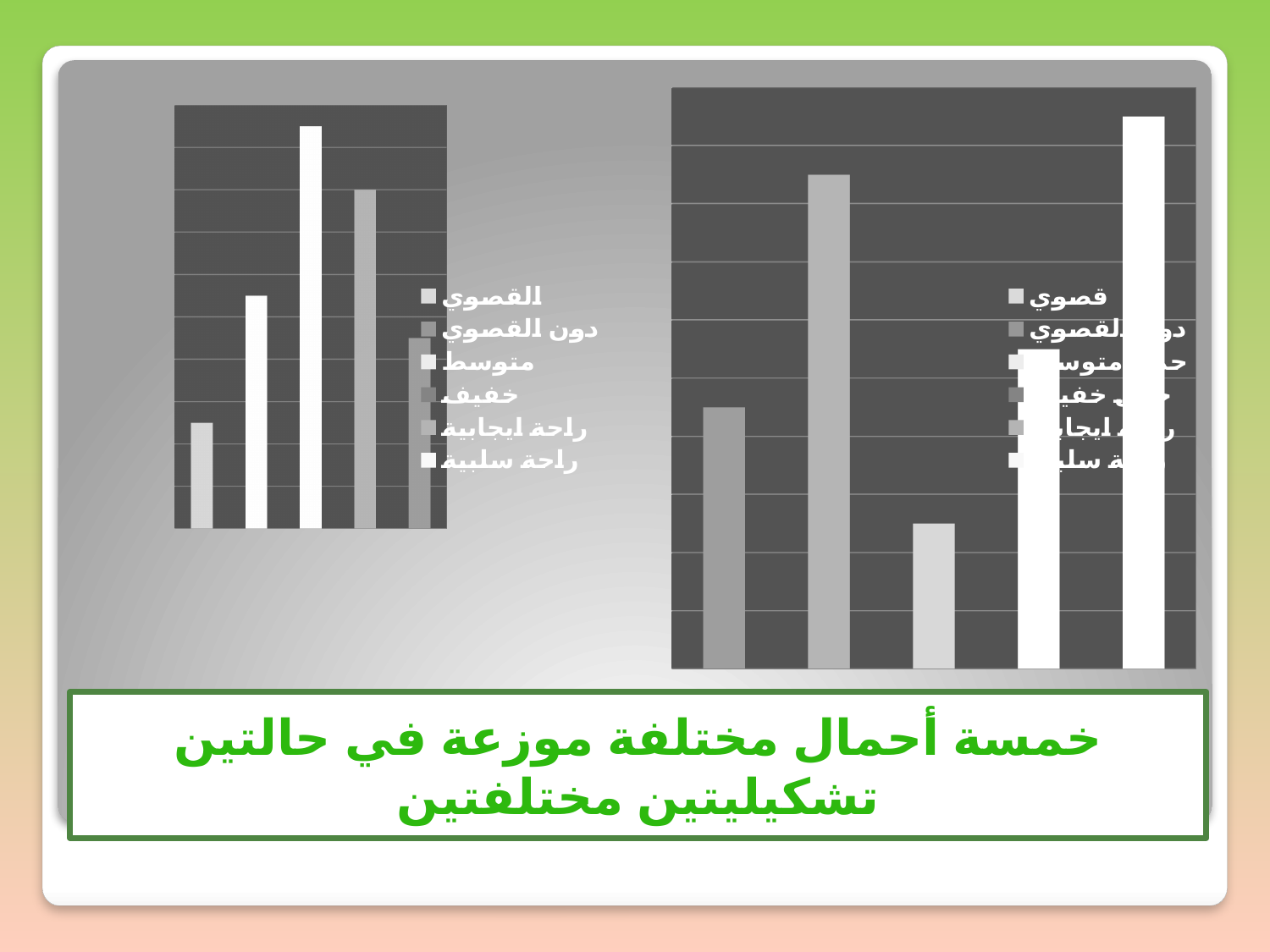
What kind of chart is the chart on the left of the slide? bar chart In the chart on the right of the slide, which bar is the shortest, counting from the left? the third bar How many entries does the legend of the chart on the right of the slide list? 6 What kind of chart is the chart on the right of the slide? bar chart How many bars are plotted in the chart on the left of the slide? 5 In the chart on the left of the slide, which is taller: the second bar or the fourth bar from the left? the fourth bar In the chart on the left of the slide, which bar is the shortest, counting from the left? the first bar In the chart on the left of the slide, which bar is the tallest, counting from the left? the third bar In the chart on the right of the slide, which bar is the tallest, counting from the left? the fifth bar How many entries does the legend of the chart on the left of the slide list? 6 How many bars are plotted in the chart on the right of the slide? 5 What is the first entry listed in the legend of the chart on the left of the slide? القصوي